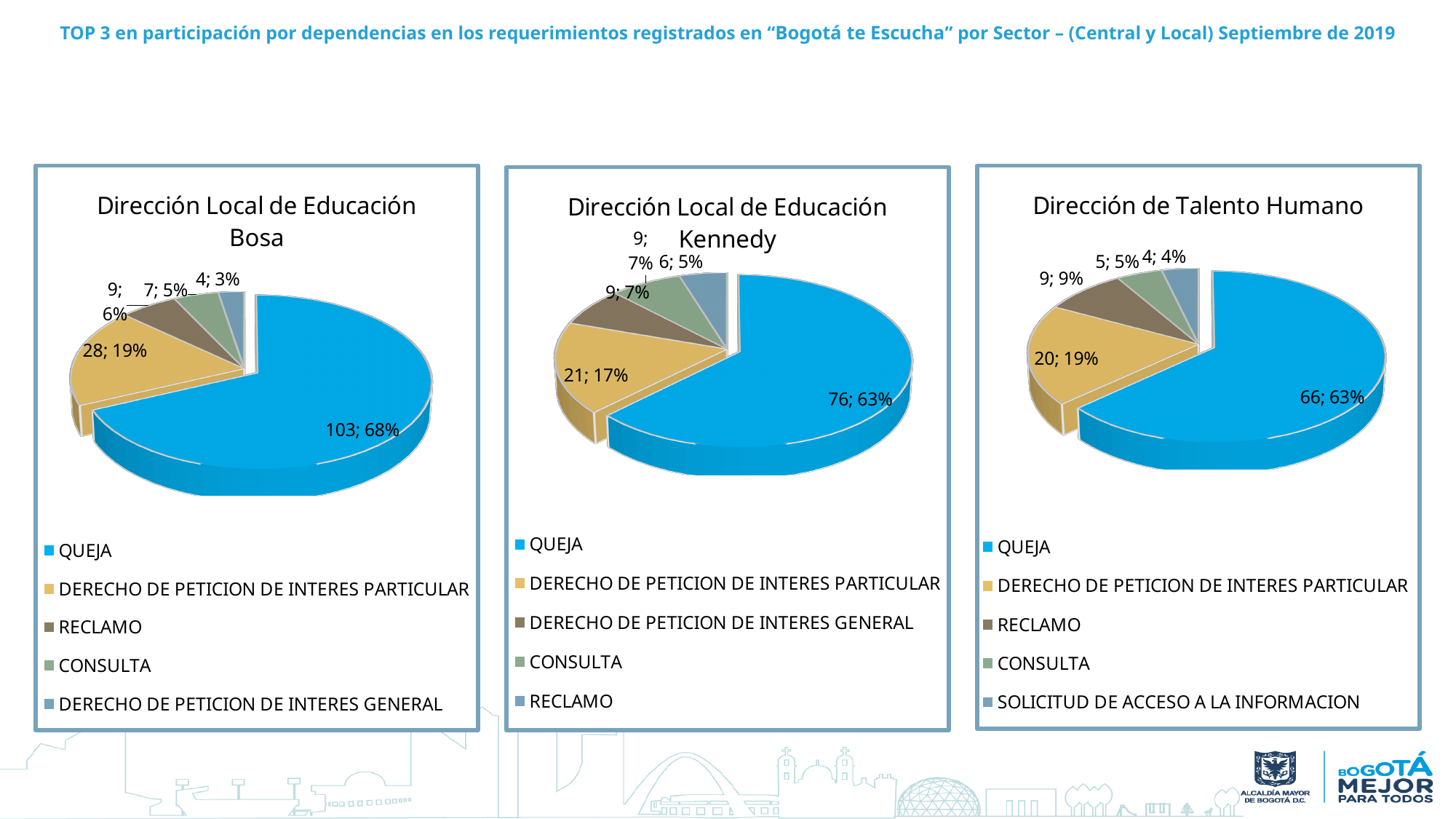
In the 'Dirección Local de Educación Kennedy' chart, which legend entry is shown in the lightest blue-grey colour? RECLAMO In the 'Dirección de Talento Humano' chart, what is the value for RECLAMO? 9; 9% In the 'Dirección Local de Educación Bosa' chart, what is the value for QUEJA? 103; 68% In the 'Dirección Local de Educación Bosa' chart, what share of the pie does DERECHO DE PETICION DE INTERES PARTICULAR represent? 19% In the 'Dirección Local de Educación Bosa' chart, which category has the lowest value? DERECHO DE PETICION DE INTERES GENERAL In the 'Dirección Local de Educación Kennedy' chart, what is the difference between the QUEJA count and the RECLAMO count? 70 In the 'Dirección Local de Educación Kennedy' chart, what is the value for DERECHO DE PETICION DE INTERES PARTICULAR? 21; 17% In the 'Dirección de Talento Humano' chart, which is larger, CONSULTA or DERECHO DE PETICION DE INTERES PARTICULAR? DERECHO DE PETICION DE INTERES PARTICULAR In the 'Dirección Local de Educación Kennedy' chart, which category has the highest value? QUEJA What type of chart is the 'Dirección Local de Educación Bosa' chart? Pie chart In the 'Dirección de Talento Humano' chart, what share of the pie does SOLICITUD DE ACCESO A LA INFORMACION represent? 4% How many categories does the 'Dirección de Talento Humano' chart show? 5